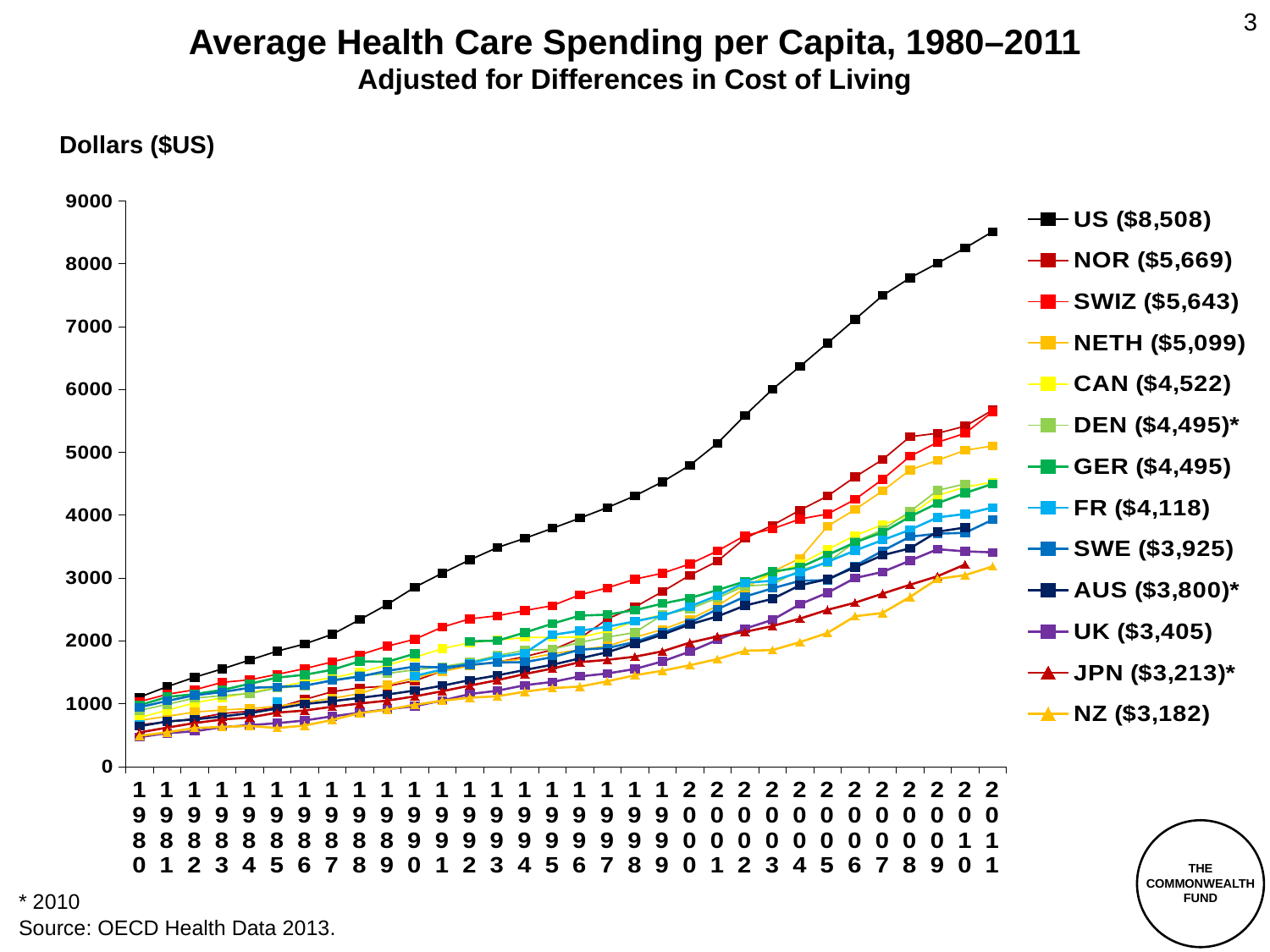
Which country has the lowest health care spending per capita according to the legend? NZ Does the US line rise or fall from 1980 to 2011? Rises What is the difference between the legend values for the US and NOR? $2,839 Which has the larger legend value, CAN or FR? CAN Is the value for NZ in 1980 greater or less than 1000? less What value does the legend give for NZ? $3,182 What kind of chart is shown on the slide? Line chart How many series does the legend list? 13 How many years are shown on the x axis? 32 Which country has the highest health care spending per capita according to the legend? US Is the value for the US in 1990 greater or less than 2000? greater What value does the legend give for the US? $8,508